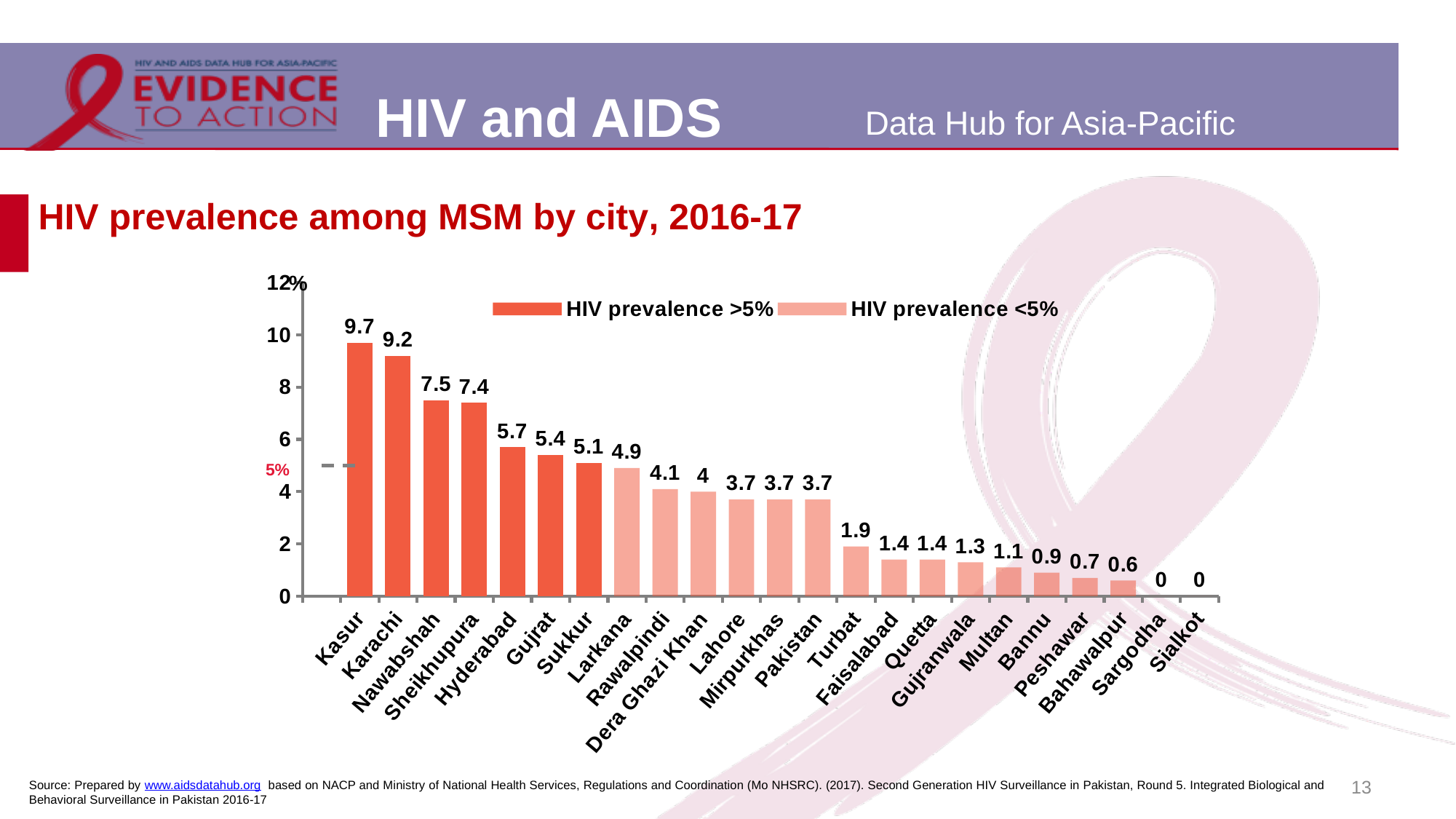
What kind of chart is shown on the slide? Bar chart How many cities/categories are shown on the x axis? 23 What is the difference between the values for Kasur and Karachi? 0.5 How many series does the legend list? 2 Which has a higher HIV prevalence, Nawabshah or Sukkur? Nawabshah What are the two legend entries of the chart? HIV prevalence >5% and HIV prevalence <5% Which has a higher HIV prevalence, Rawalpindi or Multan? Rawalpindi What is the HIV prevalence among MSM in Kasur? 9.7 What is the HIV prevalence among MSM in Larkana? 4.9 Which city has the highest HIV prevalence among MSM? Kasur What is the difference between the values for Hyderabad and Turbat? 3.8 What is the value shown for Pakistan overall? 3.7